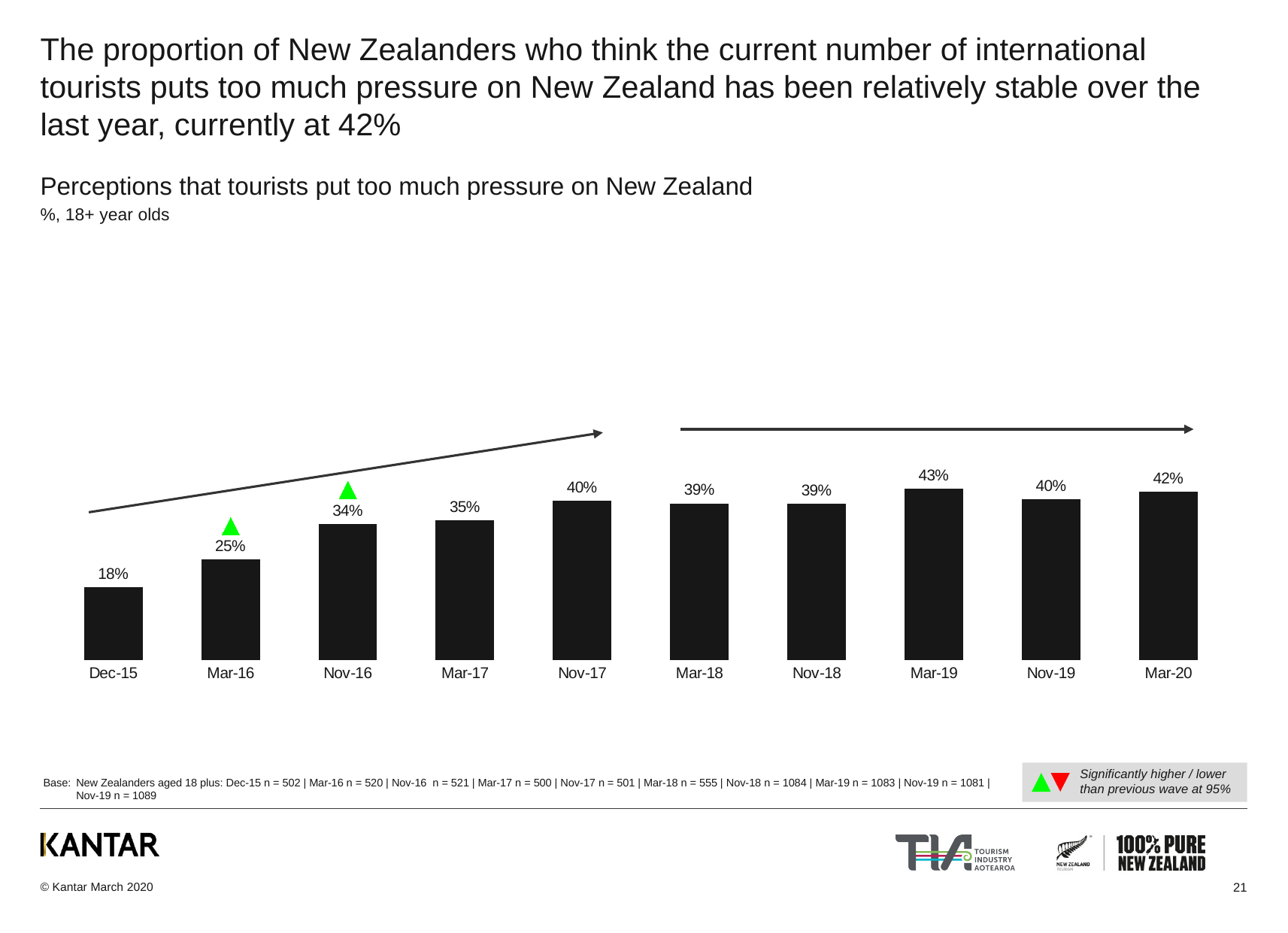
What is the value for Dec-15? 18% What is the value for Mar-20? 42% What is the value for Nov-16? 34% Which period has the lowest value? Dec-15 Which period has the highest value? Mar-19 What is the title of the chart? Perceptions that tourists put too much pressure on New Zealand Which is larger, the value for Mar-17 or the value for Nov-17? Nov-17 How many periods are shown on the x axis? 10 Do the values generally rise or fall from Dec-15 to Nov-17? Rise What is the difference between the values for Mar-20 and Dec-15? 24% What is the difference between the values for Mar-16 and Nov-16? 9% What kind of chart is this? Bar chart